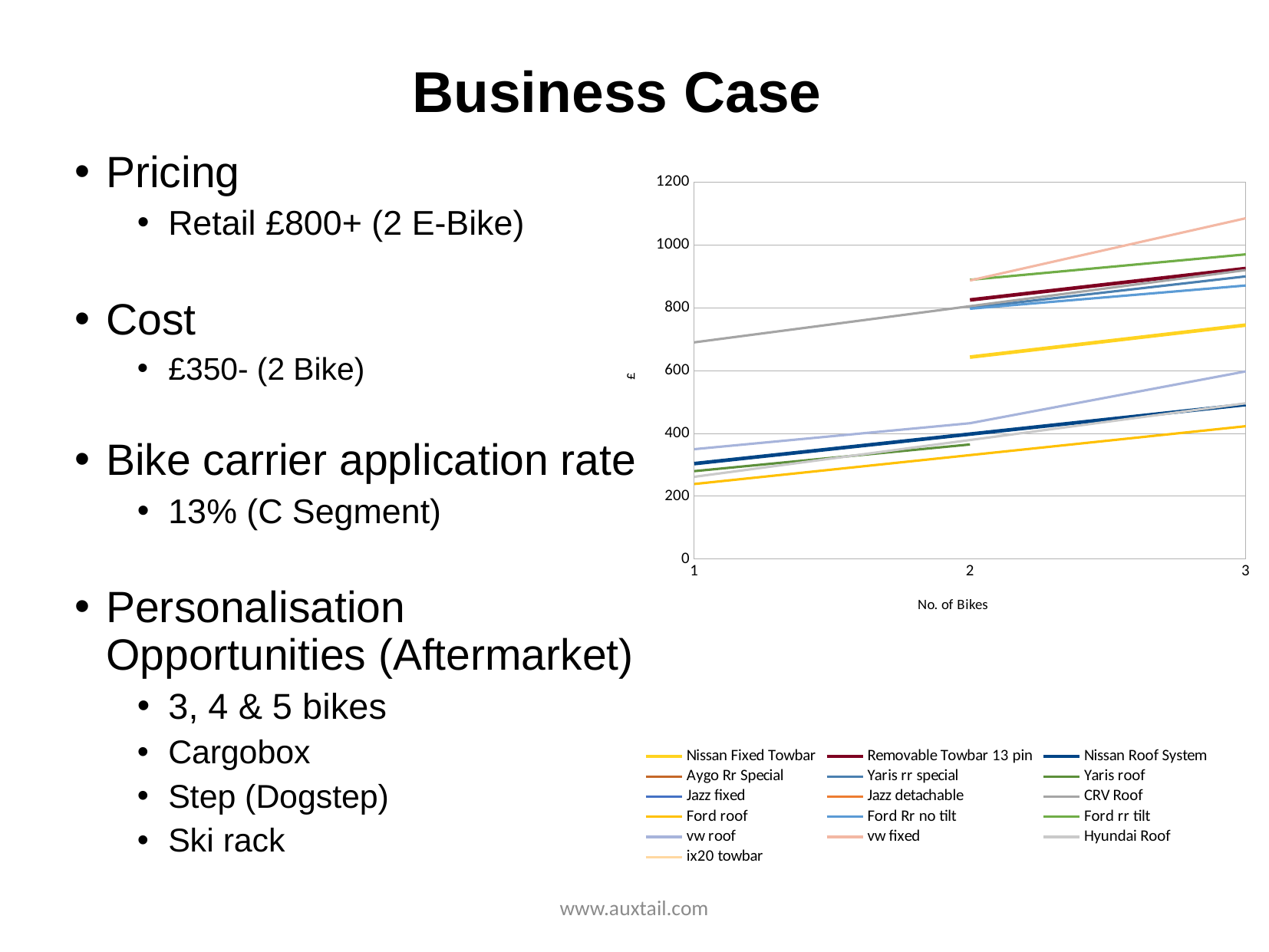
Do the plotted values rise or fall as the number of bikes increases? rise Is the value for Nissan Roof System at 1 bike greater or less than 200? greater How many points are shown on the x axis (No. of Bikes)? 3 How many series does the chart's legend list? 16 Is the value for vw fixed at 3 bikes greater or less than 1000? greater Which series has the highest value at 3 bikes? vw fixed Is the value for Removable Towbar 13 pin at 3 bikes greater or less than 800? greater Which is larger at 3 bikes, the value for vw fixed or the value for Nissan Fixed Towbar? vw fixed What is the label of the x axis? No. of Bikes What kind of chart is shown on the slide? line chart What is the label of the y axis? £